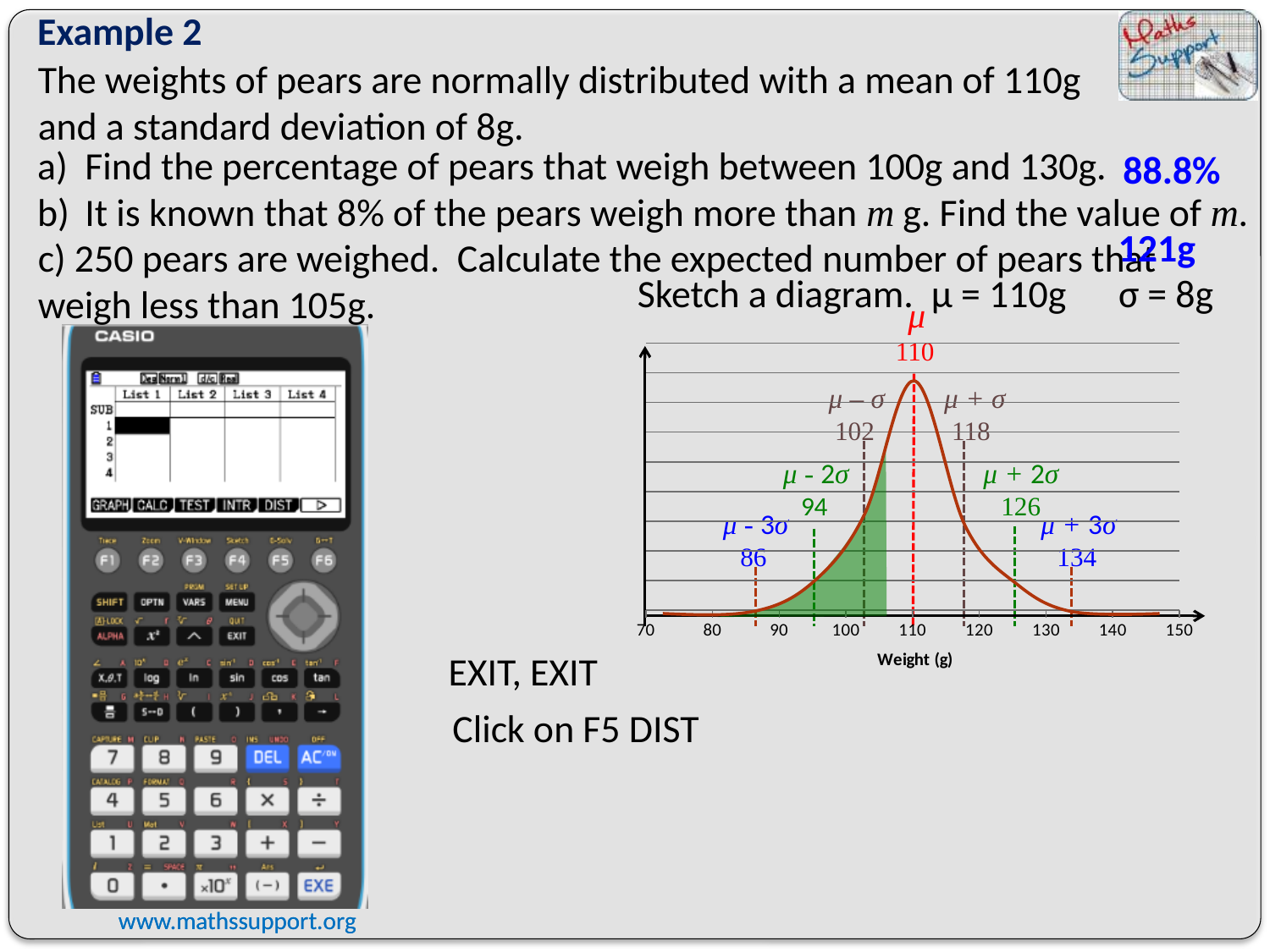
What value is labelled at μ − σ on the curve? 102 What value is labelled at μ − 2σ on the curve? 94 What kind of chart is the sketch on the right of the slide? line chart (normal distribution curve) Which is larger, the value labelled at μ + 2σ or at μ − 2σ? μ + 2σ (126) What value is labelled at μ − 3σ on the curve? 86 How many labelled positions (μ and the σ multiples) are marked along the curve? 7 What value is labelled at μ + σ on the curve? 118 What value is labelled at μ + 3σ on the curve? 134 Does the curve rise or fall as weight increases from 110 to 150? fall What is the difference between the values labelled at μ + σ and μ − σ? 16 What is the label on the horizontal axis of the sketch? Weight (g) What value is marked at the mean μ on the normal distribution sketch? 110